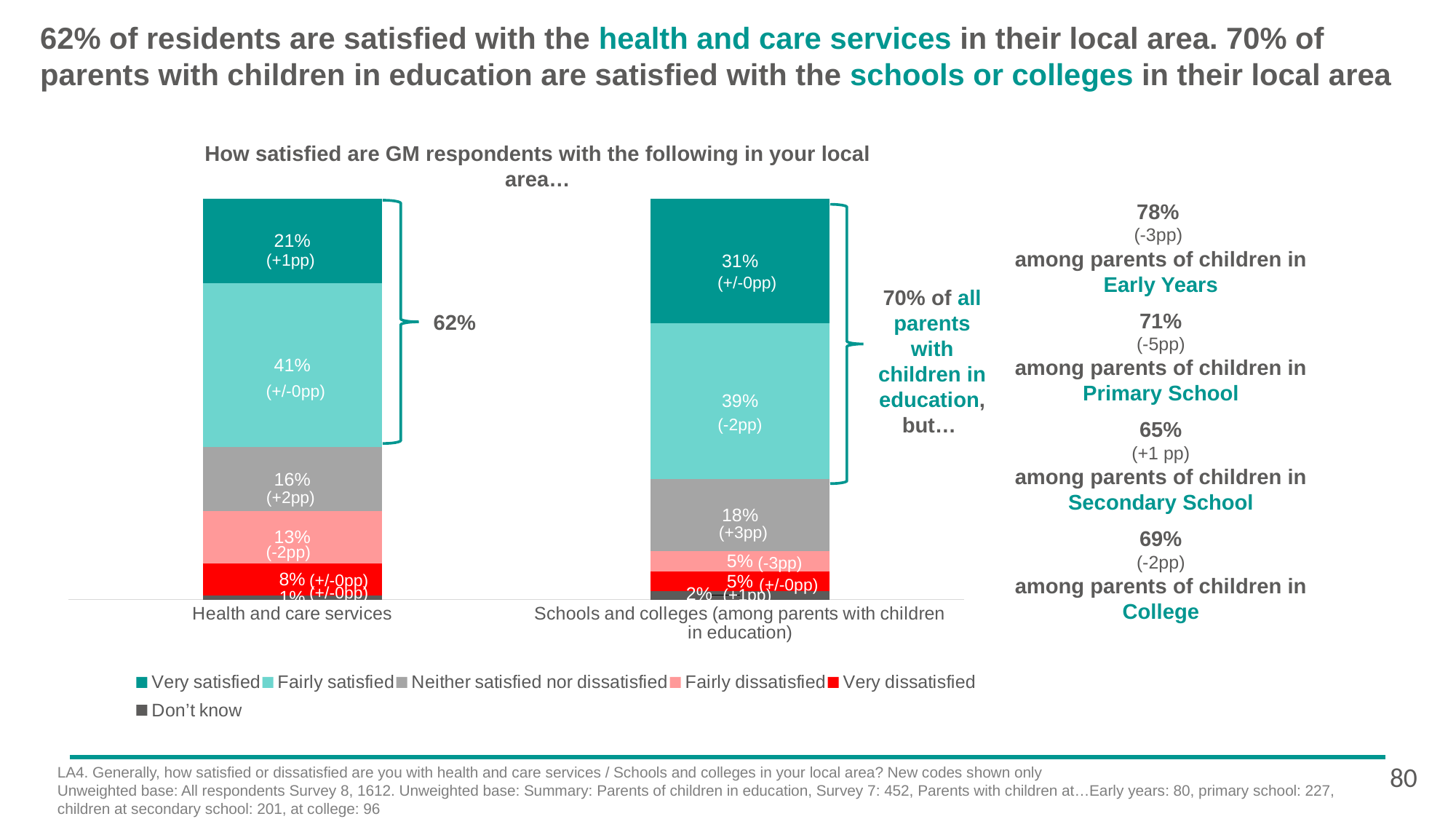
What kind of chart is shown on the slide? Stacked bar chart What percentage of parents with children in education are fairly satisfied with schools and colleges? 39% Which legend entry is shown in bright red? Very dissatisfied Which category has the larger 'Very satisfied' share: health and care services or schools and colleges? Schools and colleges What is the combined share of very satisfied and fairly satisfied respondents for health and care services? 62% How many series does the legend list? 6 What percentage of respondents are neither satisfied nor dissatisfied with health and care services? 16% What is the difference between the 'Fairly dissatisfied' share for health and care services and for schools and colleges? 8 percentage points What is the combined share of very satisfied and fairly satisfied parents for schools and colleges? 70% How many categories are shown on the x axis of the chart? 2 What percentage of respondents are very satisfied with health and care services? 21% What percentage of parents are very dissatisfied with schools and colleges? 5%